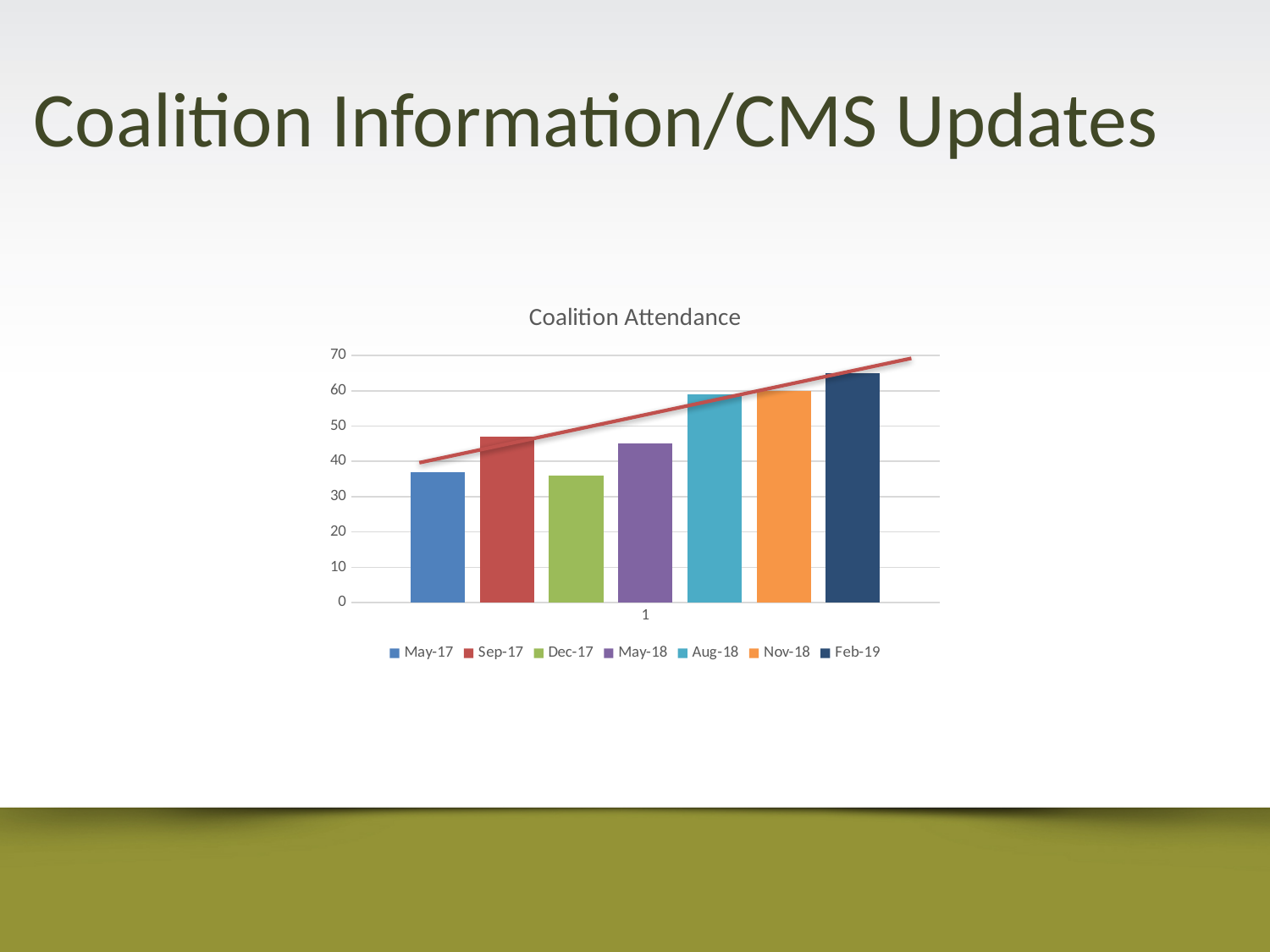
How many series does the legend list? 7 Is the value for May-17 greater or less than 40? less Is the value for Dec-17 greater or less than 40? less What kind of chart is shown on the slide? Bar chart Which is larger, the value for Sep-17 or the value for May-17? Sep-17 What is the title of the chart? Coalition Attendance Is the value for Feb-19 greater or less than 70? less Does the red trend line rise or fall from left to right? Rise Which is larger, the value for Feb-19 or the value for May-18? Feb-19 Which series has the highest bar? Feb-19